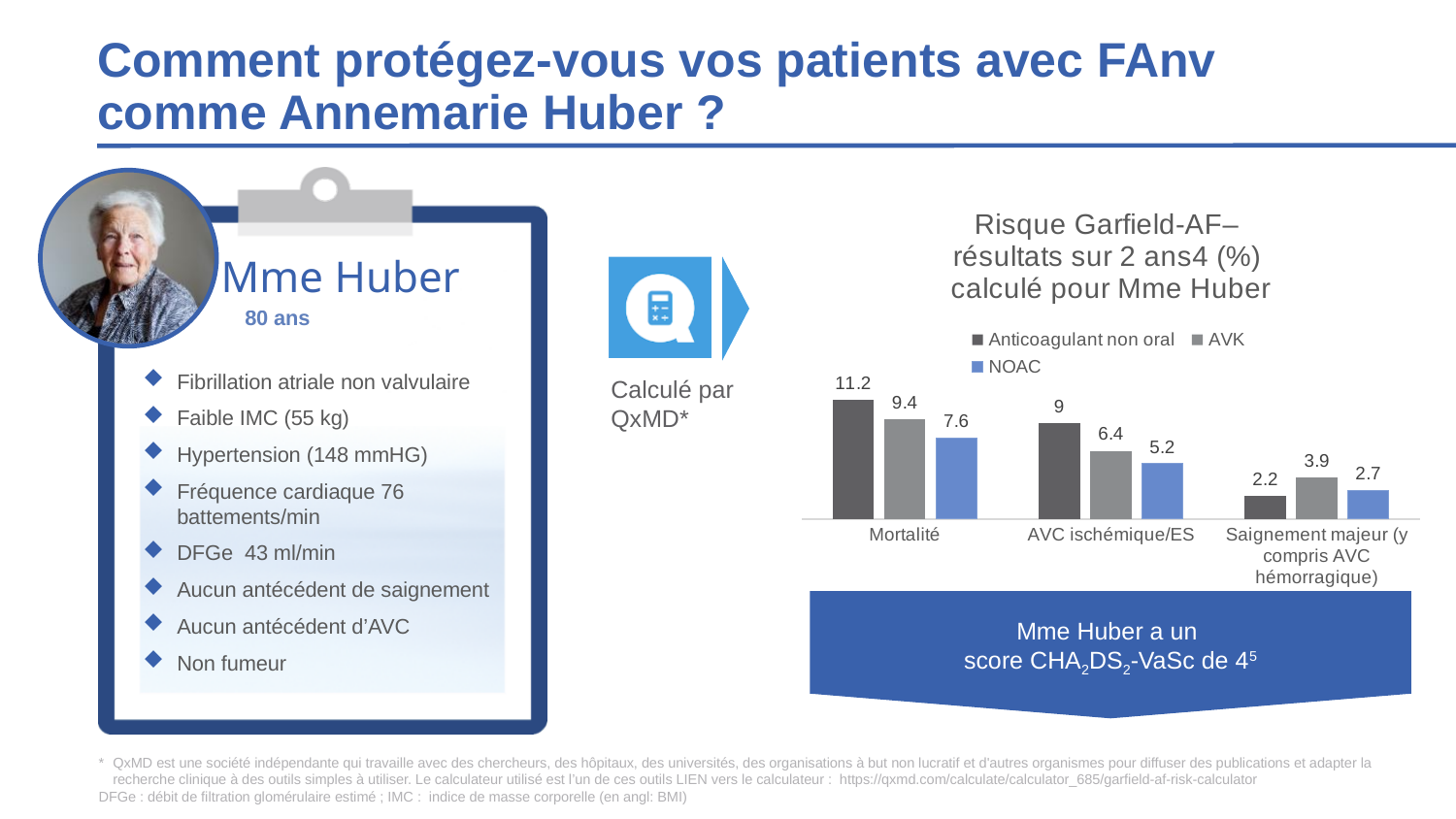
What is the value for NOAC in the AVC ischémique/ES category? 5.2 What is the value for AVK in the Saignement majeur (y compris AVC hémorragique) category? 3.9 What is the difference between the AVK and NOAC values in the AVC ischémique/ES category? 1.2 Which series has the lowest value in the Mortalité category? NOAC What kind of chart is shown on the slide? Bar chart Which series has the highest value in the Saignement majeur (y compris AVC hémorragique) category? AVK What is the difference between the Anticoagulant non oral and NOAC values in the Mortalité category? 3.6 Which is larger in the AVC ischémique/ES category: Anticoagulant non oral or AVK? Anticoagulant non oral Which category has the highest value for NOAC? Mortalité How many categories are shown on the x axis? 3 What is the value for Anticoagulant non oral in the Mortalité category? 11.2 How many series does the legend list? 3